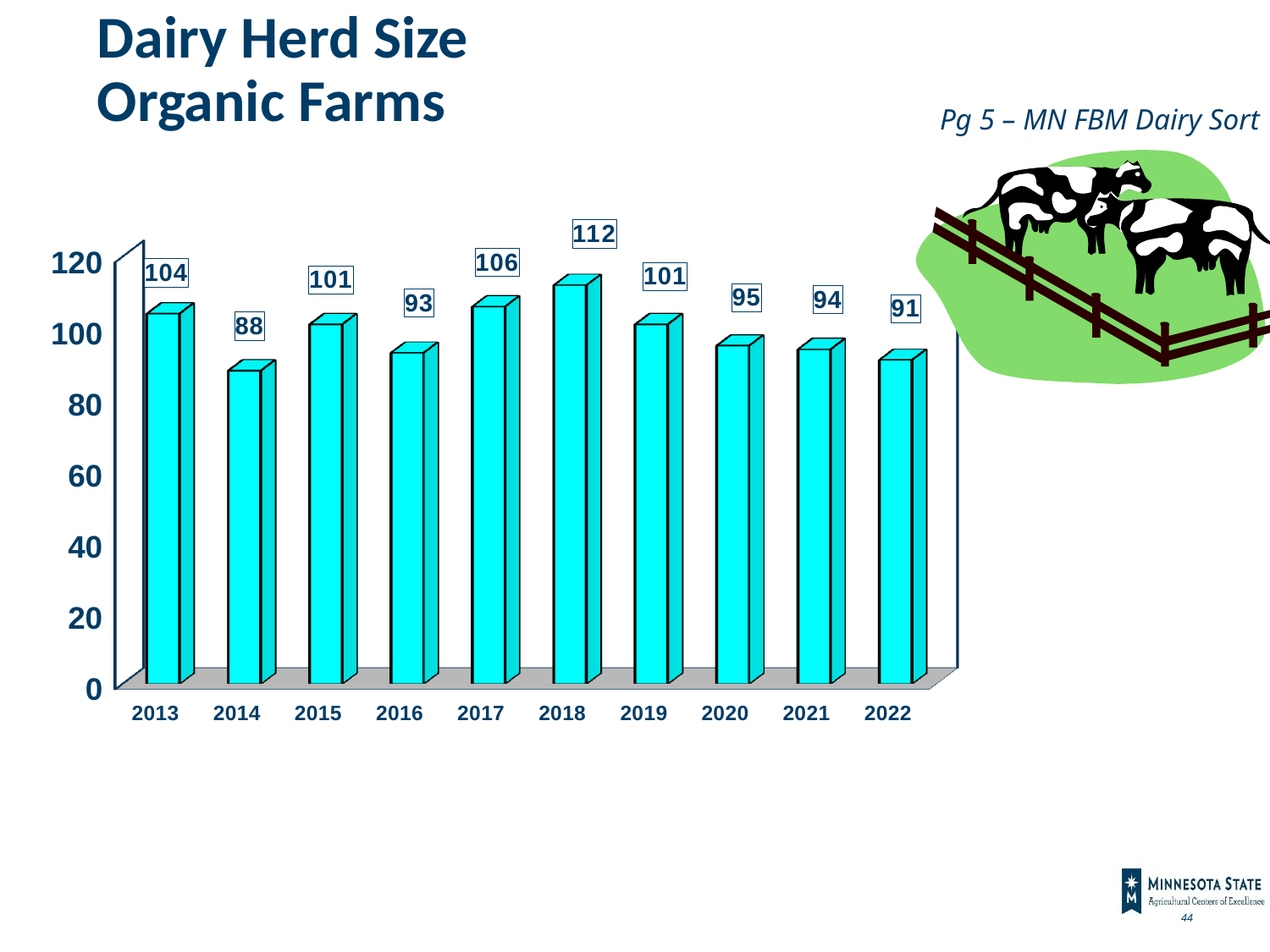
What is the dairy herd size for organic farms in 2018? 112 What is the difference between the dairy herd size in 2018 and in 2014? 24 What is the dairy herd size for organic farms in 2022? 91 Which year has the highest dairy herd size? 2018 Is the dairy herd size in 2016 greater or less than 100? less How many years are shown on the chart? 10 Which year has a larger dairy herd size, 2017 or 2019? 2017 Which year has the lowest dairy herd size? 2014 Does the dairy herd size rise or fall from 2018 to 2022? fall What kind of chart is shown on the slide? bar chart What is the dairy herd size for organic farms in 2014? 88 What is the difference between the dairy herd size in 2013 and in 2022? 13